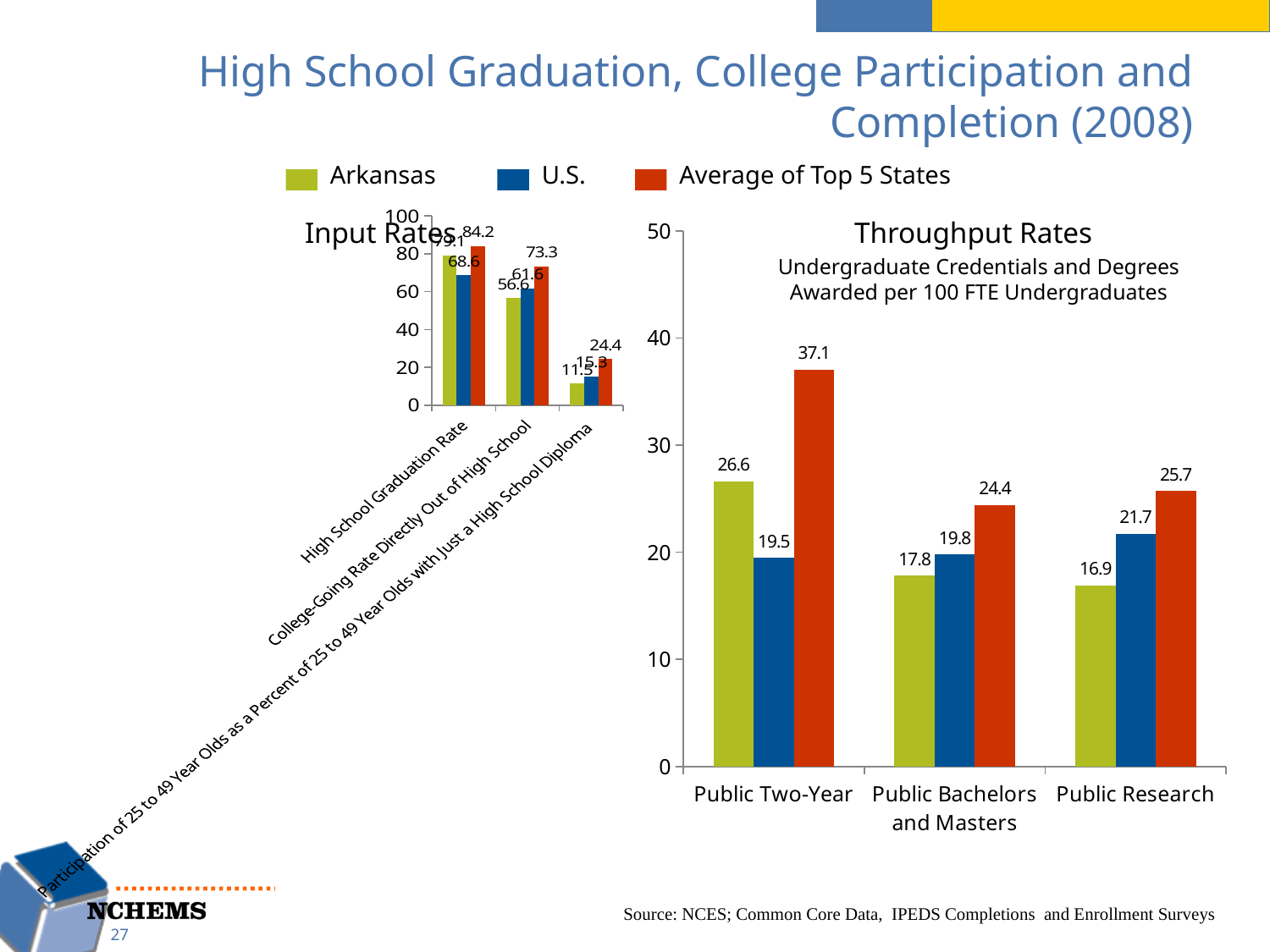
In the Throughput Rates chart, which category has the highest Average of Top 5 States value? Public Two-Year In the Throughput Rates chart, how many categories are shown on the x axis? 3 In the Throughput Rates chart, what is the difference between the Average of Top 5 States value and the Arkansas value for Public Two-Year? 10.5 What kind of chart is the Throughput Rates chart? Bar chart In the Throughput Rates chart, which category has the lowest Arkansas value? Public Research How many series does the legend list? 3 In the Throughput Rates chart, what is the Arkansas value for Public Research? 16.9 In the Throughput Rates chart, what is the U.S. value for Public Bachelors and Masters? 19.8 In the Throughput Rates chart, what is the value for Average of Top 5 States for Public Two-Year? 37.1 In the Input Rates chart, what is the Average of Top 5 States value for High School Graduation Rate? 84.2 In the Throughput Rates chart, which is larger for Public Two-Year: the Arkansas value or the U.S. value? Arkansas In the Input Rates chart, what is the Average of Top 5 States value for College-Going Rate Directly Out of High School? 73.3